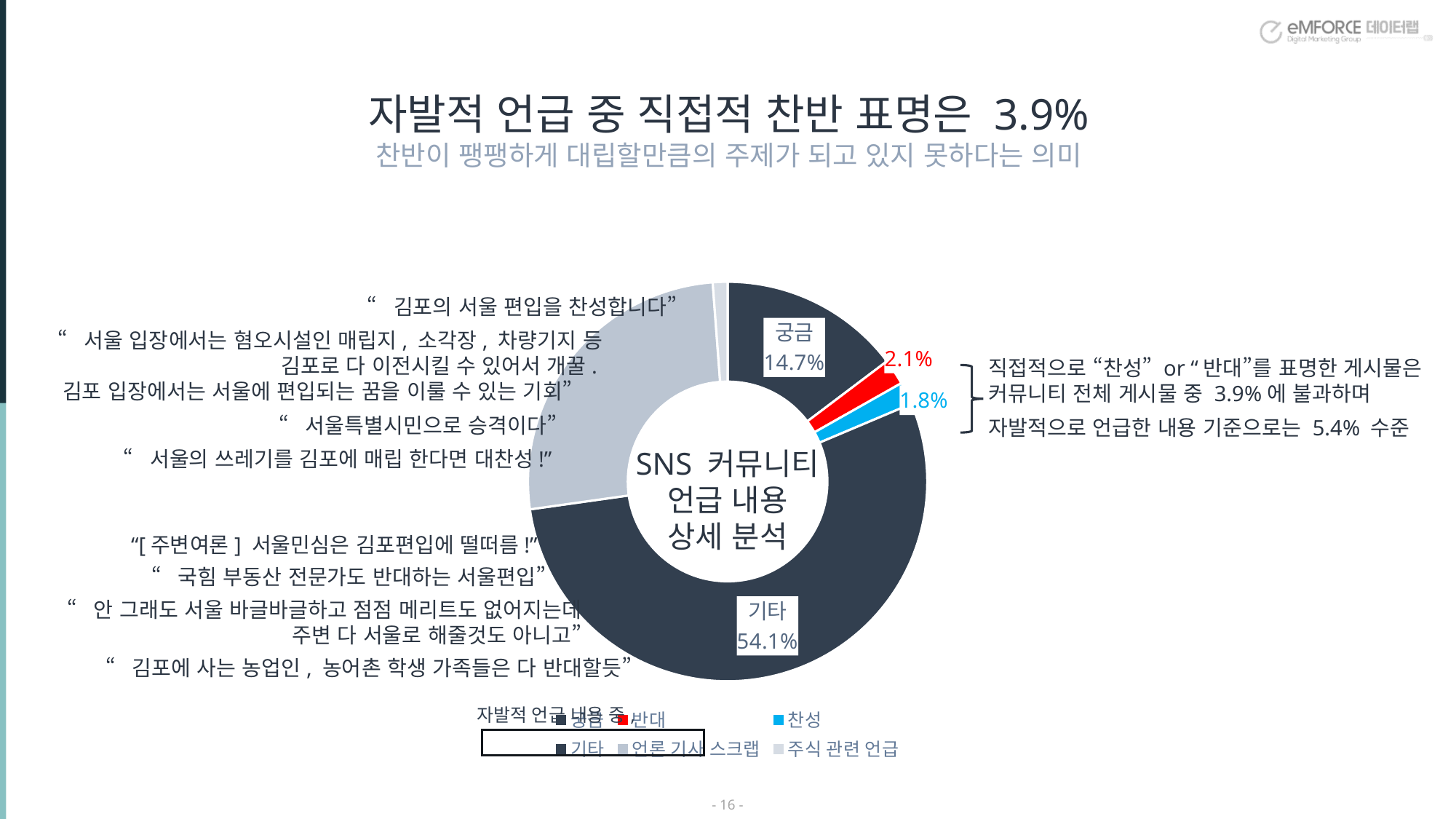
What percentage is shown for the 찬성 slice in the donut chart? 1.8% Which slice is larger in the donut chart, 반대 or 찬성? 반대 What text appears in the center of the donut chart? SNS 커뮤니티 언급 내용 상세 분석 What percentage does the 궁금 slice represent in the donut chart? 14.7% What is the difference between the 기타 and 궁금 percentages in the donut chart? 39.4% What percentage is shown for the 반대 slice in the donut chart? 2.1% How many categories does the legend of the donut chart list? 6 What is the combined percentage of the 반대 and 찬성 slices in the donut chart? 3.9% What type of chart is shown on the slide? Donut (pie) chart Which category has the largest share in the donut chart? 기타 What percentage does the 기타 slice represent in the donut chart? 54.1% What is the difference between the 반대 and 찬성 percentages in the donut chart? 0.3%